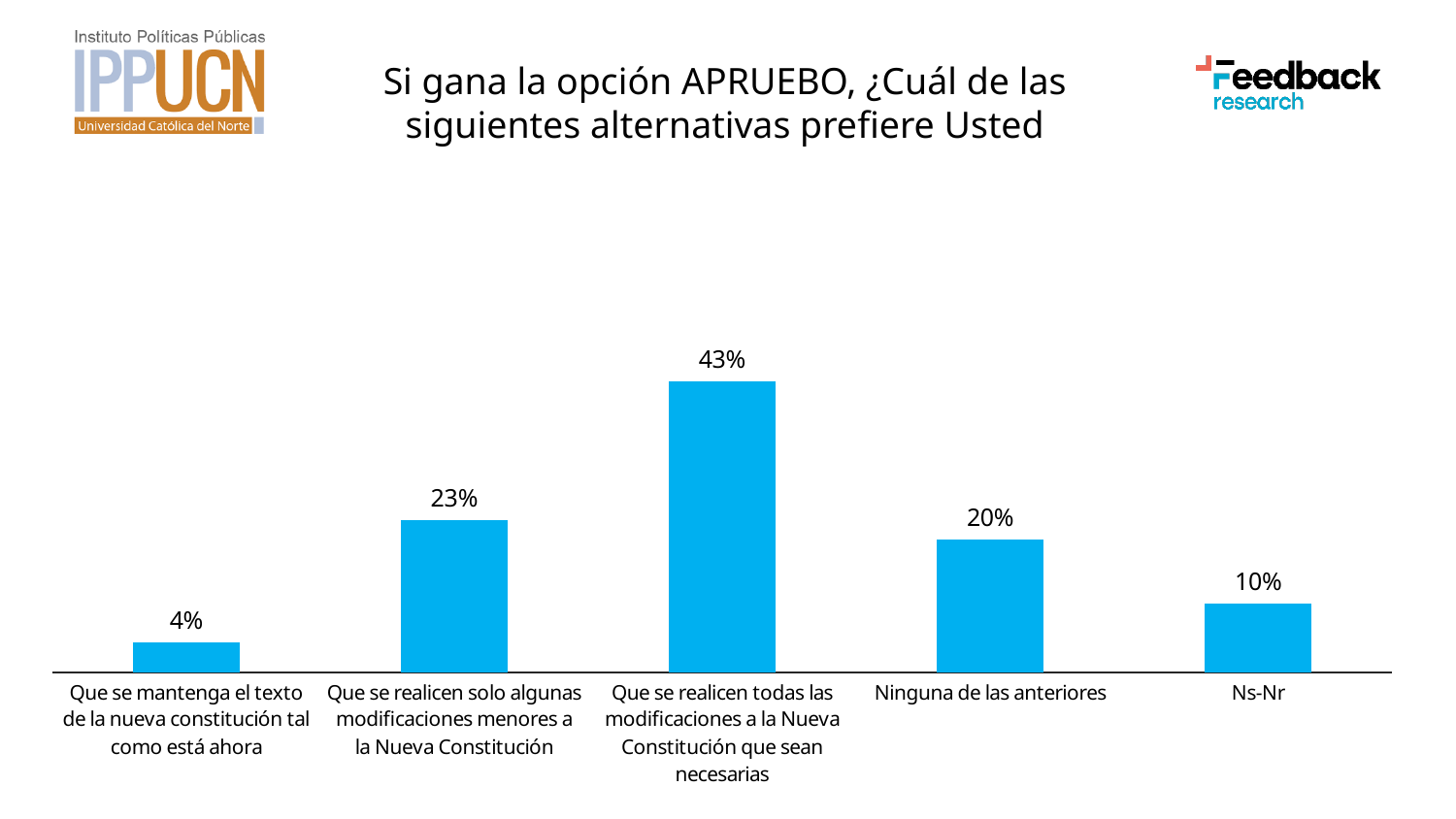
What is the value shown for "Ns-Nr"? 10% How many categories are shown in the chart? 5 What percentage of respondents chose "Que se realicen todas las modificaciones a la Nueva Constitución que sean necesarias"? 43% What is the difference between the values for "Ninguna de las anteriores" and "Ns-Nr"? 10% Which is larger: the value for "Que se realicen solo algunas modificaciones menores a la Nueva Constitución" or the value for "Ninguna de las anteriores"? Que se realicen solo algunas modificaciones menores a la Nueva Constitución What kind of chart is shown on the slide? Bar chart What is the value for "Que se mantenga el texto de la nueva constitución tal como está ahora"? 4% Which category has the highest value? Que se realicen todas las modificaciones a la Nueva Constitución que sean necesarias Which category has the lowest value? Que se mantenga el texto de la nueva constitución tal como está ahora What is the title of the chart? Si gana la opción APRUEBO, ¿Cuál de las siguientes alternativas prefiere Usted What is the difference between the values for "Que se realicen todas las modificaciones a la Nueva Constitución que sean necesarias" and "Que se realicen solo algunas modificaciones menores a la Nueva Constitución"? 20% What percentage is shown for "Ninguna de las anteriores"? 20%